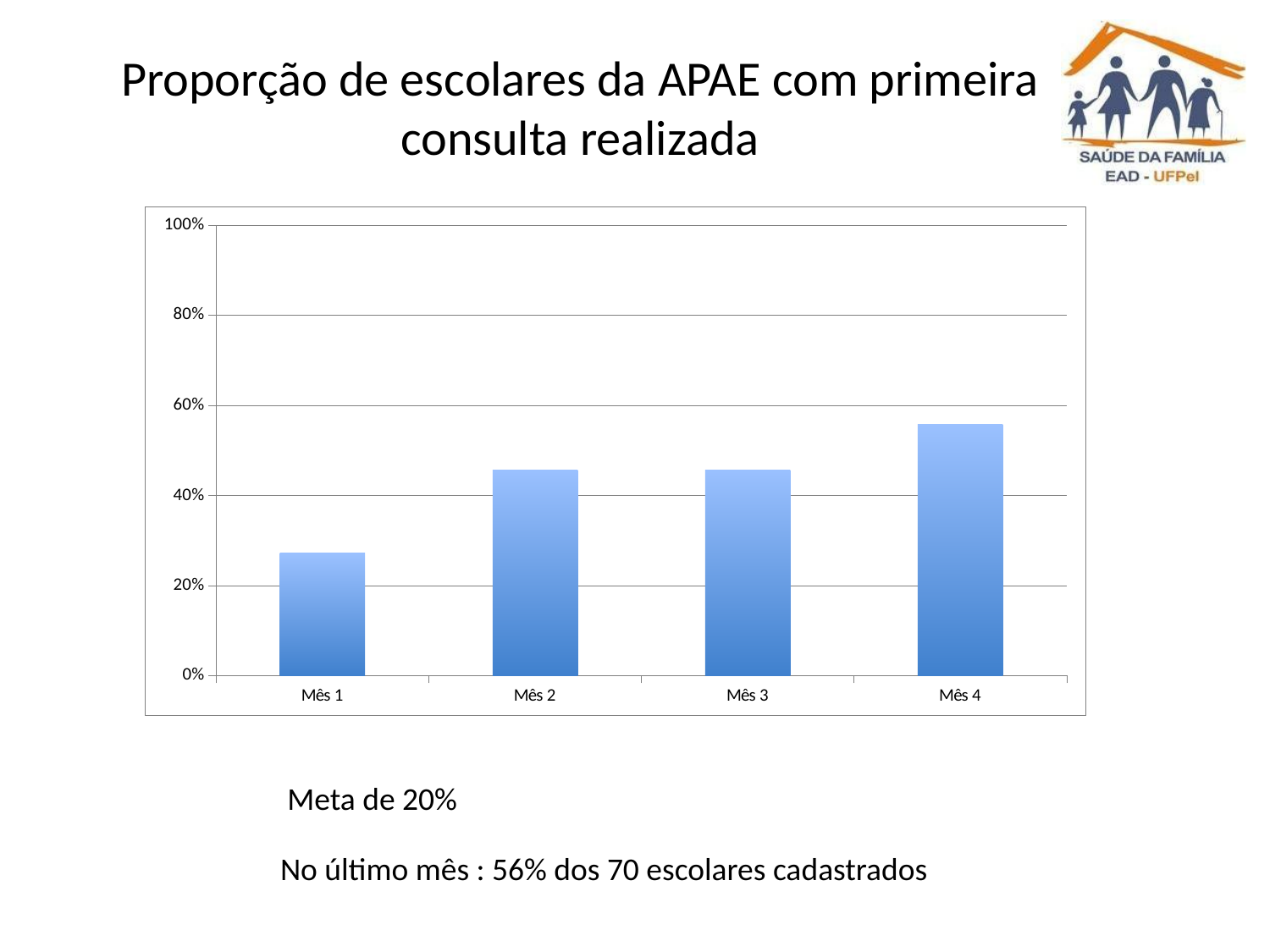
Do the values generally rise or fall from Mês 1 to Mês 4? rise What is the title of the slide containing the chart? Proporção de escolares da APAE com primeira consulta realizada Which is larger, the value for Mês 1 or the value for Mês 4? Mês 4 What kind of chart is shown on the slide? bar chart Is the value for Mês 4 greater or less than 60%? less Is the value for Mês 3 greater or less than 60%? less How many categories (months) are plotted on the x axis? 4 Is the value for Mês 2 greater or less than 40%? greater Which month has the highest proportion? Mês 4 Which month has the lowest proportion? Mês 1